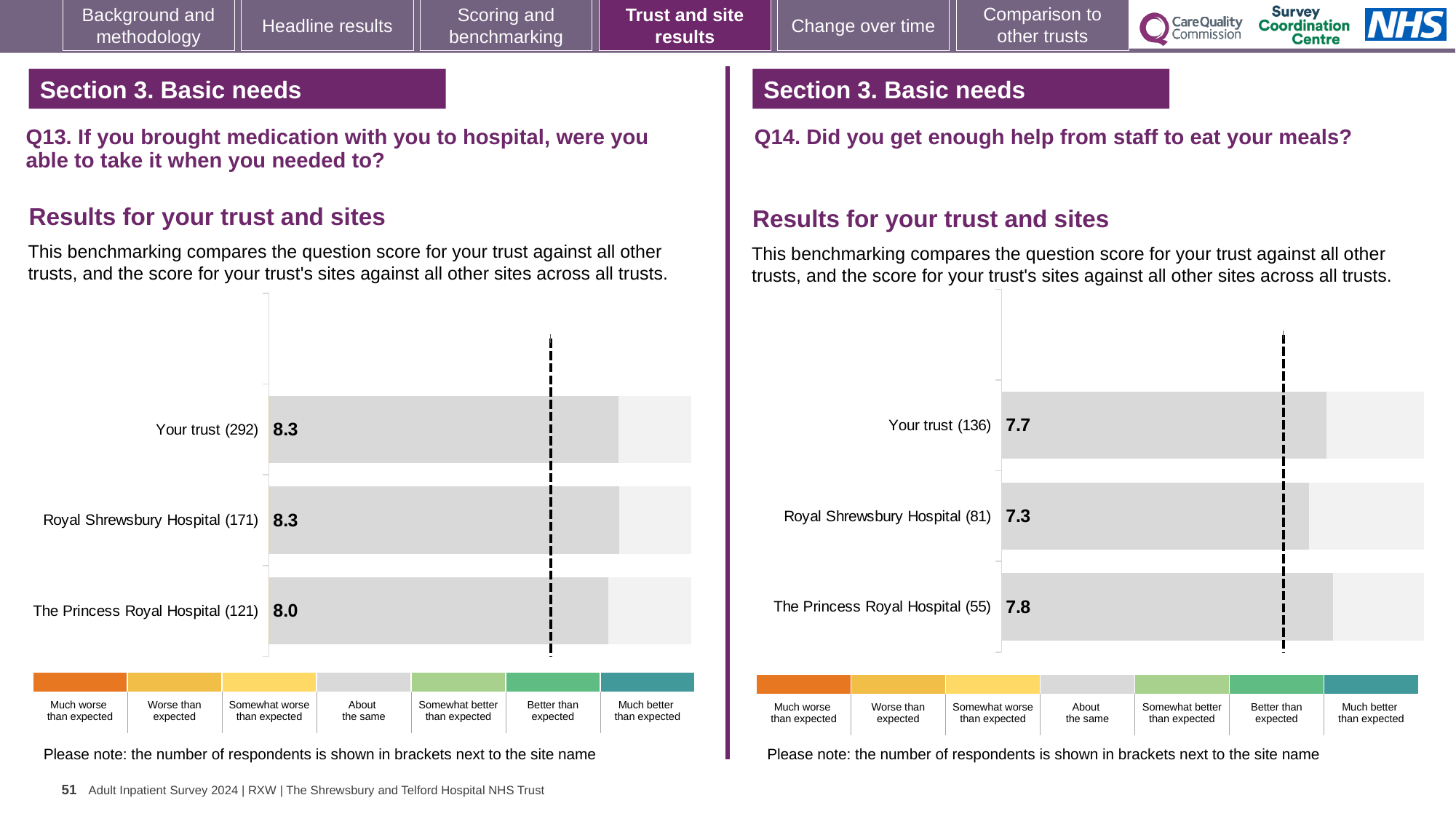
How many bars are plotted on the Q14 chart (right)? 3 On the Q13 chart (left), what is the difference between the scores for Your trust and The Princess Royal Hospital? 0.3 On the Q14 chart (right), which site or trust has the highest score? The Princess Royal Hospital On the Q13 chart (left), which has the lowest score? The Princess Royal Hospital What type of chart is used on the Q13 chart (left)? Bar chart On the Q13 chart (left), what is the score for Your trust? 8.3 On the Q13 chart (left), which has the larger score: Royal Shrewsbury Hospital or The Princess Royal Hospital? Royal Shrewsbury Hospital On the Q13 chart (left), what is the score for The Princess Royal Hospital? 8.0 On the Q14 chart (right), what is the difference between the scores for The Princess Royal Hospital and Royal Shrewsbury Hospital? 0.5 On the Q14 chart (right), what is the score for Royal Shrewsbury Hospital? 7.3 On the Q14 chart (right), what is the score for Your trust? 7.7 On the Q14 chart (right), which site or trust has the lowest score? Royal Shrewsbury Hospital